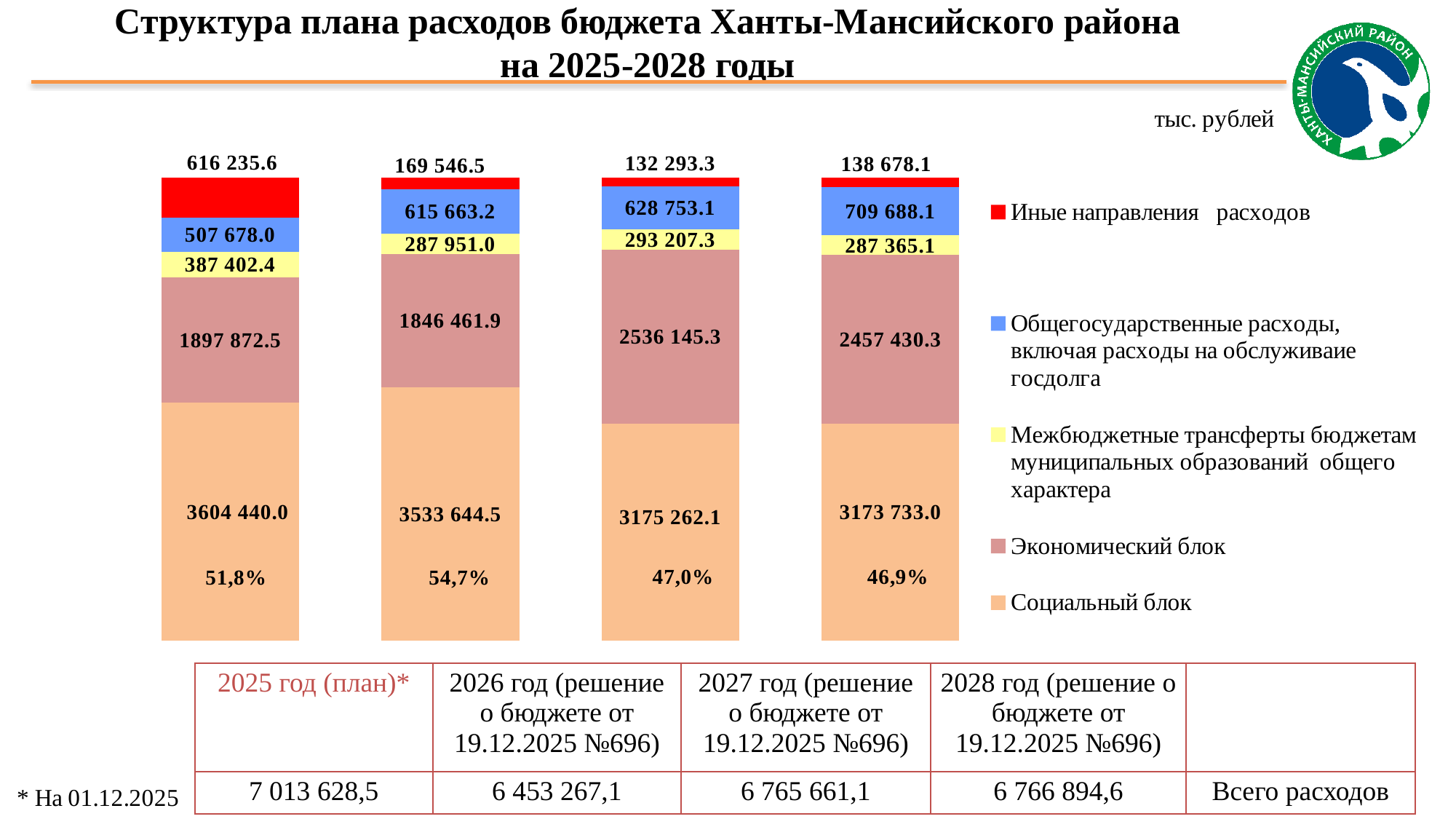
What is the value of Общегосударственные расходы for 2028 год? 709 688.1 How many stacked bars (years) are shown in the chart? 4 In which year is the Социальный блок value the highest? 2025 год (план) What is the difference between the Социальный блок values for 2025 and 2026? 70 795.5 What is the value of Иные направления расходов for 2025 год (план)? 616 235.6 In which year is the Экономический блок value the lowest? 2026 год What is the value of Социальный блок for 2025 год (план)? 3604 440.0 What share of total expenditures does Социальный блок make up in 2025 год (план)? 51,8% What kind of chart is shown on the slide? Stacked bar chart Which is larger: Общегосударственные расходы in 2027 or in 2028? 2028 What is the value of Экономический блок for 2027 год? 2536 145.3 How many series does the legend list? 5